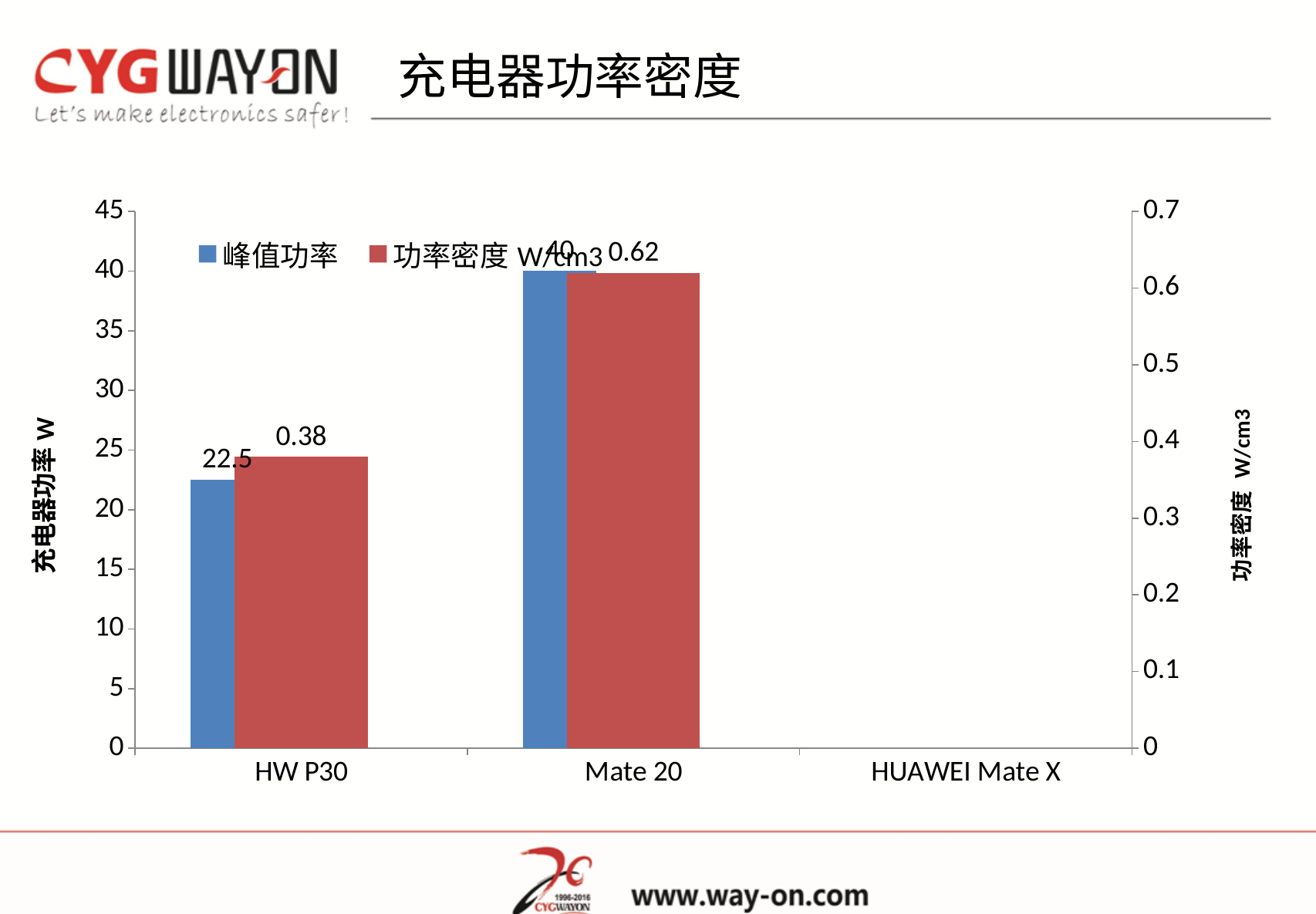
Which category has the highest 峰值功率? Mate 20 Which has a larger 功率密度, HW P30 or Mate 20? Mate 20 What is the title of the chart on the slide? 充电器功率密度 What kind of chart is shown on the slide? Bar chart What is the 峰值功率 value for Mate 20? 40 How many series does the legend list? 2 What is the 功率密度 value for Mate 20? 0.62 What is the difference in 峰值功率 between Mate 20 and HW P30? 17.5 What is the difference in 功率密度 between Mate 20 and HW P30? 0.24 What is the 功率密度 value for HW P30? 0.38 How many categories are shown on the x axis? 3 What is the 峰值功率 value for HW P30? 22.5